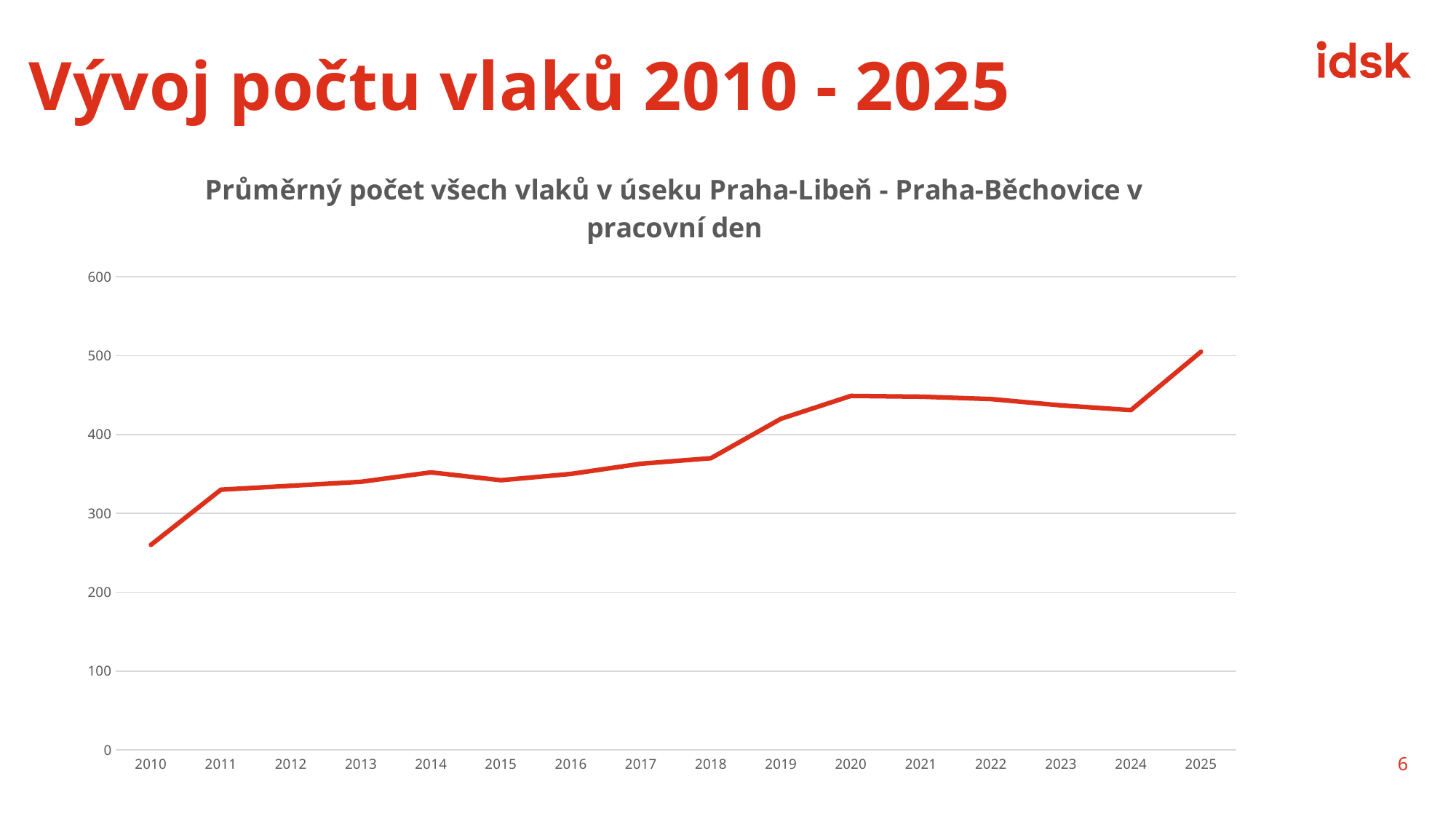
Is the value for 2019 greater or less than 400? greater Do the values generally rise or fall from 2010 to 2025? rise What kind of chart is shown on the slide? line chart Which year has a larger value, 2018 or 2019? 2019 Which year has the highest average number of trains? 2025 Is the value for 2024 greater or less than 400? greater Which year has the lowest average number of trains? 2010 What colour is the plotted line? red Is the value for 2010 greater or less than 300? less Which year has a larger value, 2010 or 2011? 2011 How many years are plotted on the x axis? 16